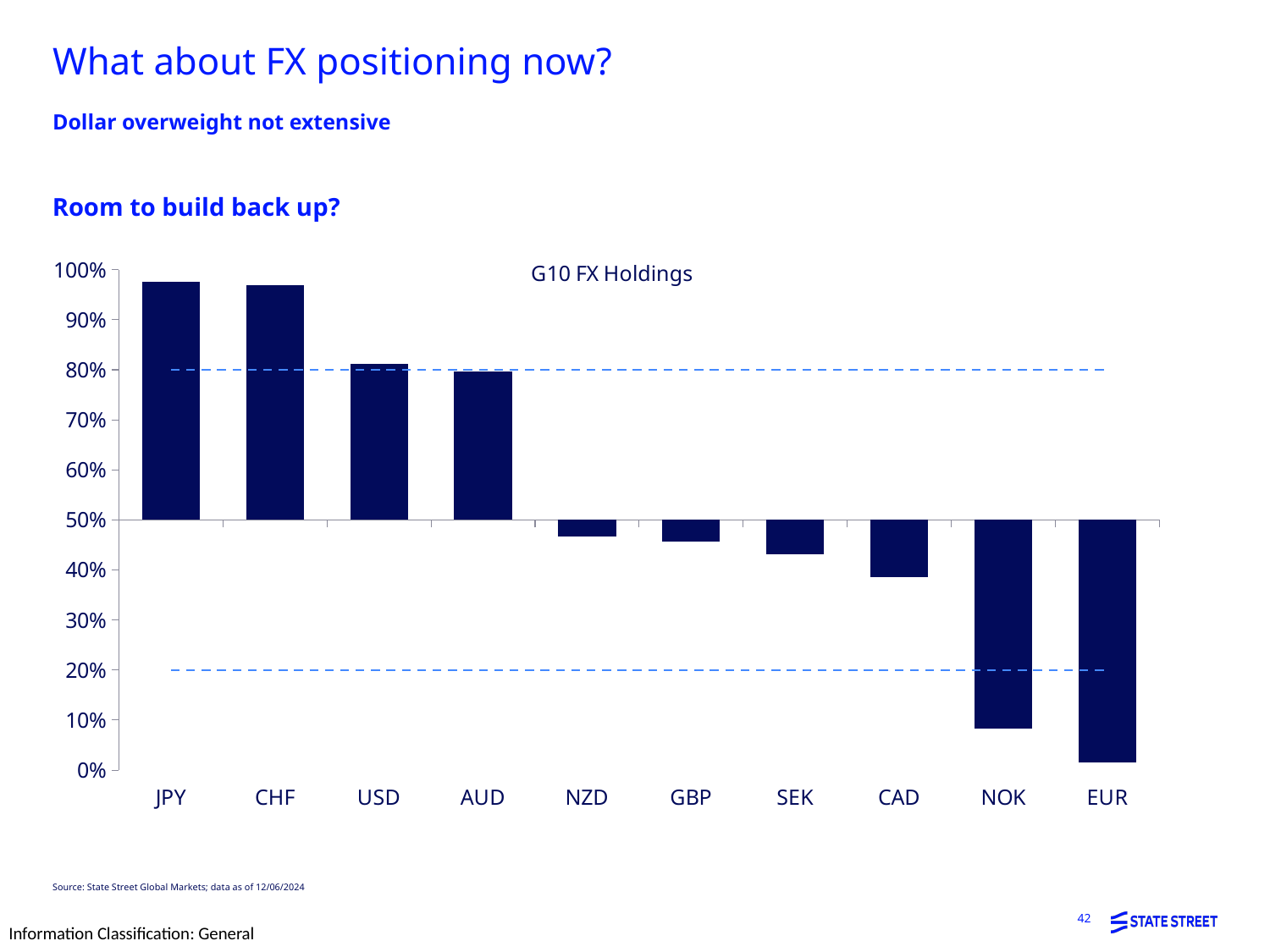
Is the value for CAD greater or less than 40%? less How many currencies are shown on the x axis of the chart? 10 Is the value for NZD greater or less than 50%? less What is the title of the chart? G10 FX Holdings Is the value for JPY greater or less than 90%? greater Do the values rise or fall moving from left to right along the x axis? fall Which has the larger value, USD or CAD? USD Which currency has the lowest holdings value in the chart? EUR What kind of chart is shown on the slide? bar chart Which has the larger value, NOK or EUR? NOK